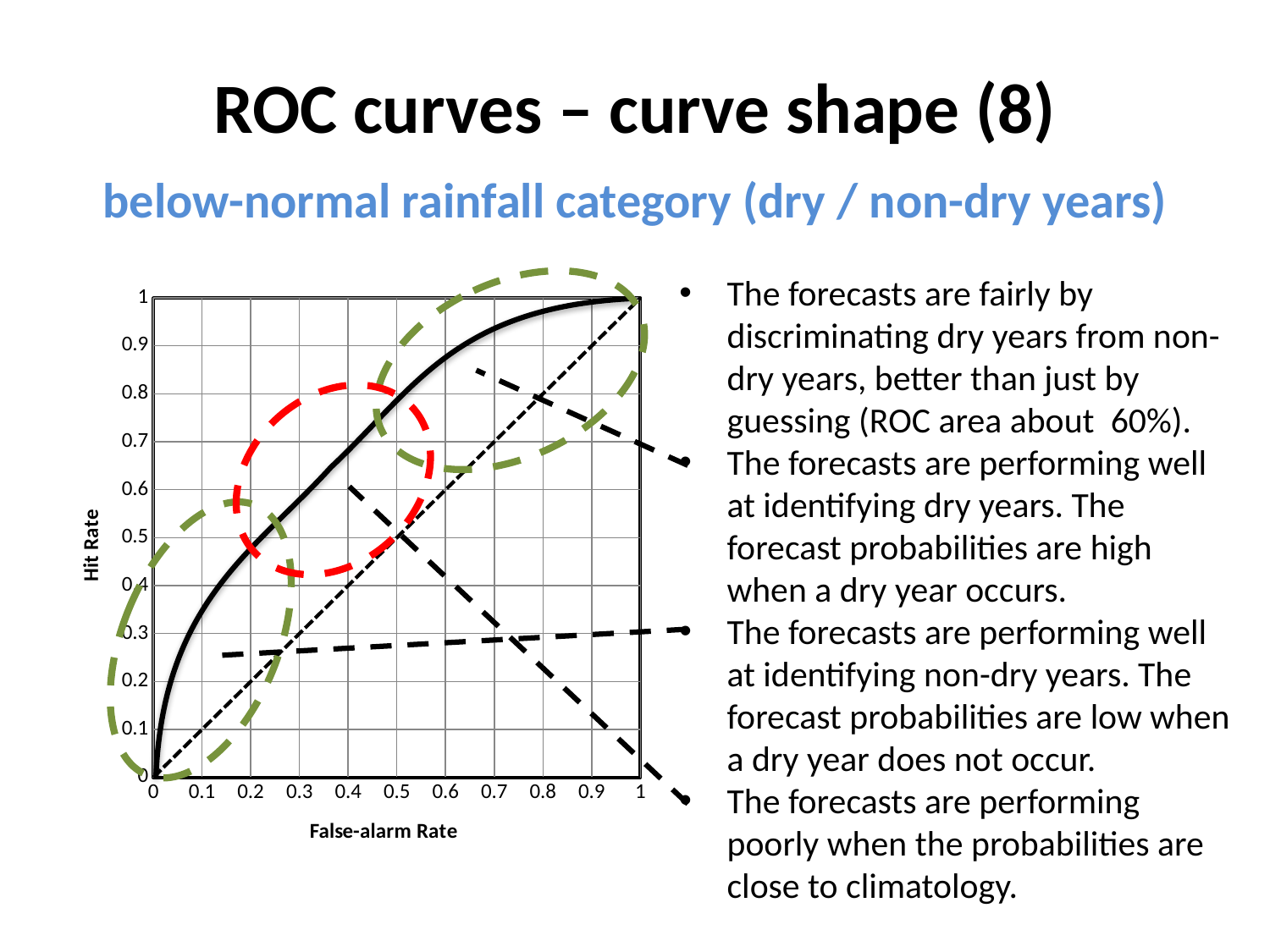
What is the highest value shown on the y axis of the chart? 1 What type of chart is shown on the slide? line chart What is the title of the y axis of the chart? Hit Rate Is the hit rate of the solid curve at a false-alarm rate of 0.3 greater or less than 0.8? less What is the lowest value shown on the x axis of the chart? 0 What is the title of the x axis of the chart? False-alarm Rate Is the hit rate of the solid curve at a false-alarm rate of 0.5 greater or less than 0.6? greater What is the hit rate of the solid curve at a false-alarm rate of 1? 1 Is the hit rate of the solid curve at a false-alarm rate of 0.2 greater or less than 0.4? greater Does the solid ROC curve rise or fall as the false-alarm rate increases from 0 to 1? rise At a false-alarm rate of 0.4, which is higher: the solid ROC curve or the thin dashed diagonal line? the solid ROC curve